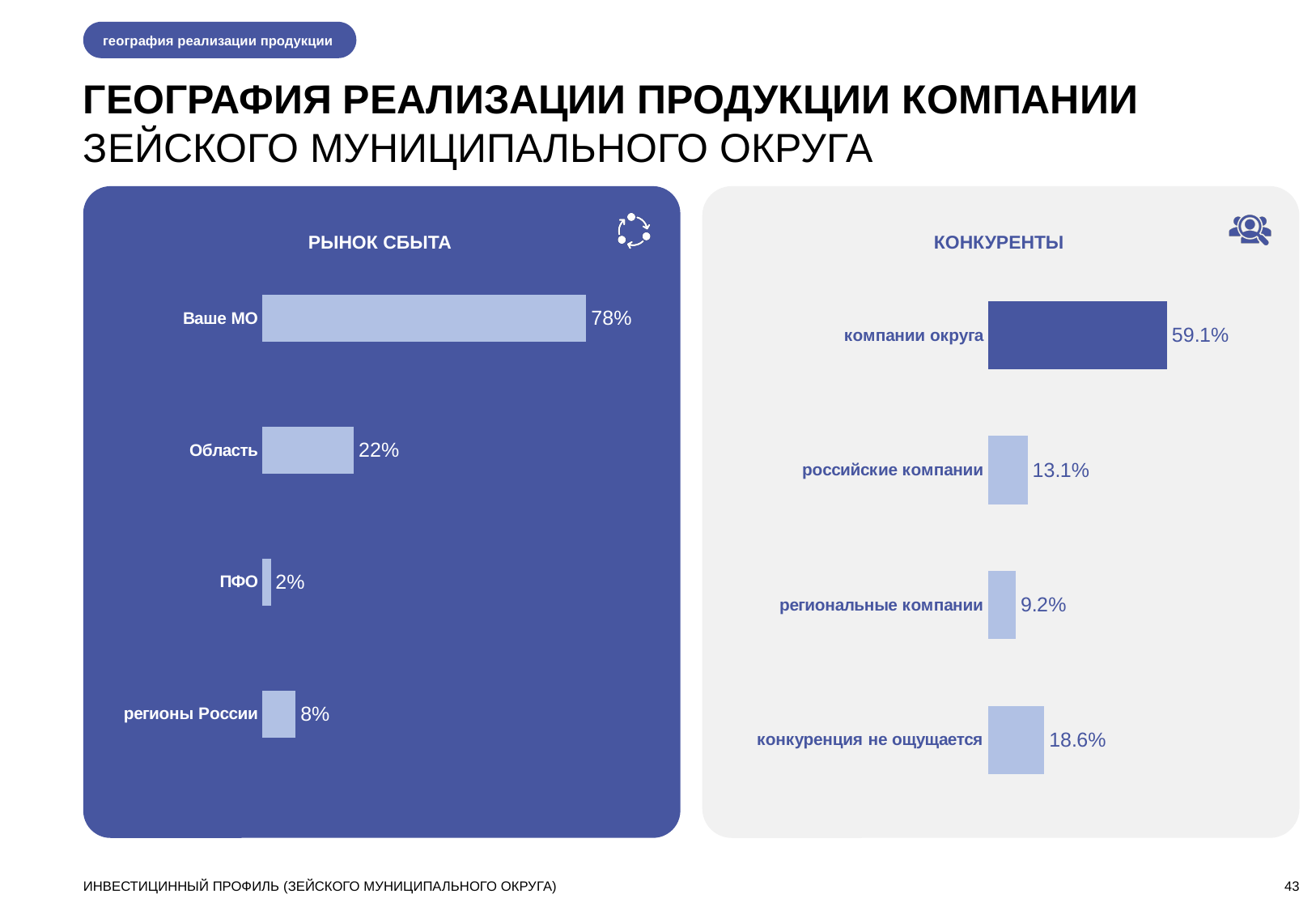
In the 'КОНКУРЕНТЫ' chart, what is the value for 'российские компании'? 13.1% In the 'КОНКУРЕНТЫ' chart, which is larger: 'российские компании' or 'конкуренция не ощущается'? конкуренция не ощущается In the 'РЫНОК СБЫТА' chart, what is the value for 'Область'? 22% In the 'РЫНОК СБЫТА' chart, what is the difference between 'Ваше МО' and 'Область'? 56% In the 'РЫНОК СБЫТА' chart, which category has the lowest value? ПФО In the 'РЫНОК СБЫТА' chart, how many categories are shown? 4 In the 'КОНКУРЕНТЫ' chart, which category has the lowest value? региональные компании In the 'КОНКУРЕНТЫ' chart, what is the difference between 'компании округа' and 'российские компании'? 46.0% In the 'КОНКУРЕНТЫ' chart, what is the value for 'конкуренция не ощущается'? 18.6% In the 'КОНКУРЕНТЫ' chart, which category has the highest value? компании округа What type of chart is the 'КОНКУРЕНТЫ' chart? Bar chart In the 'РЫНОК СБЫТА' chart, what is the value for 'Ваше МО'? 78%